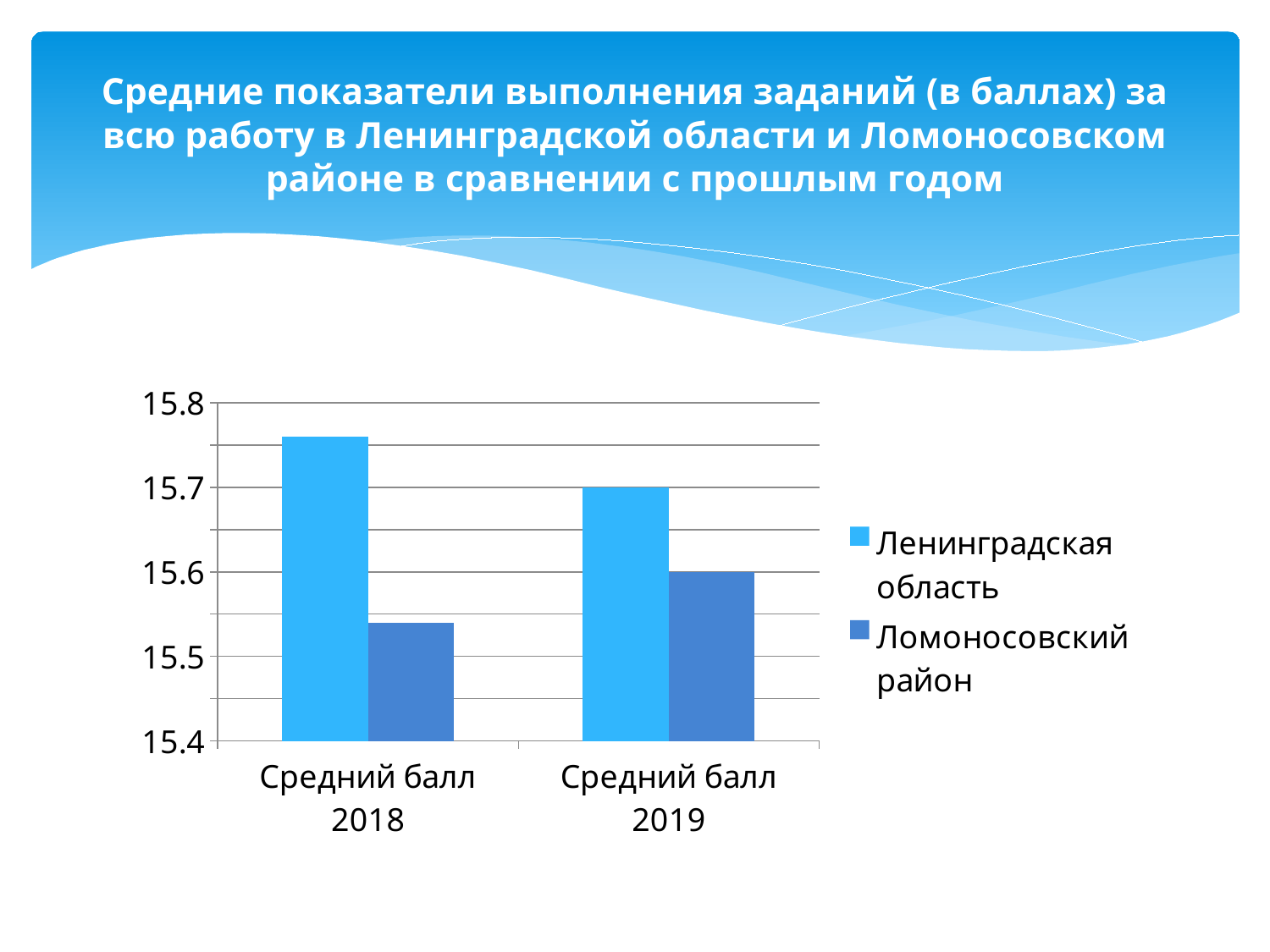
What is the value for Ленинградская область in Средний балл 2019? 15.7 Which bar is the highest in the chart? Ленинградская область, Средний балл 2018 Which series is shown in the darker blue colour? Ломоносовский район What kind of chart is shown on the slide? bar chart What is the value for Ломоносовский район in Средний балл 2019? 15.6 How many series does the legend list? 2 Does the value for Ломоносовский район rise or fall from 2018 to 2019? rise Is the value for Ломоносовский район in Средний балл 2018 greater or less than 15.6? less Which bar is the lowest in the chart? Ломоносовский район, Средний балл 2018 How many categories are shown on the x axis? 2 Is the value for Ленинградская область in Средний балл 2018 greater or less than 15.7? greater Which is larger in Средний балл 2019: Ленинградская область or Ломоносовский район? Ленинградская область